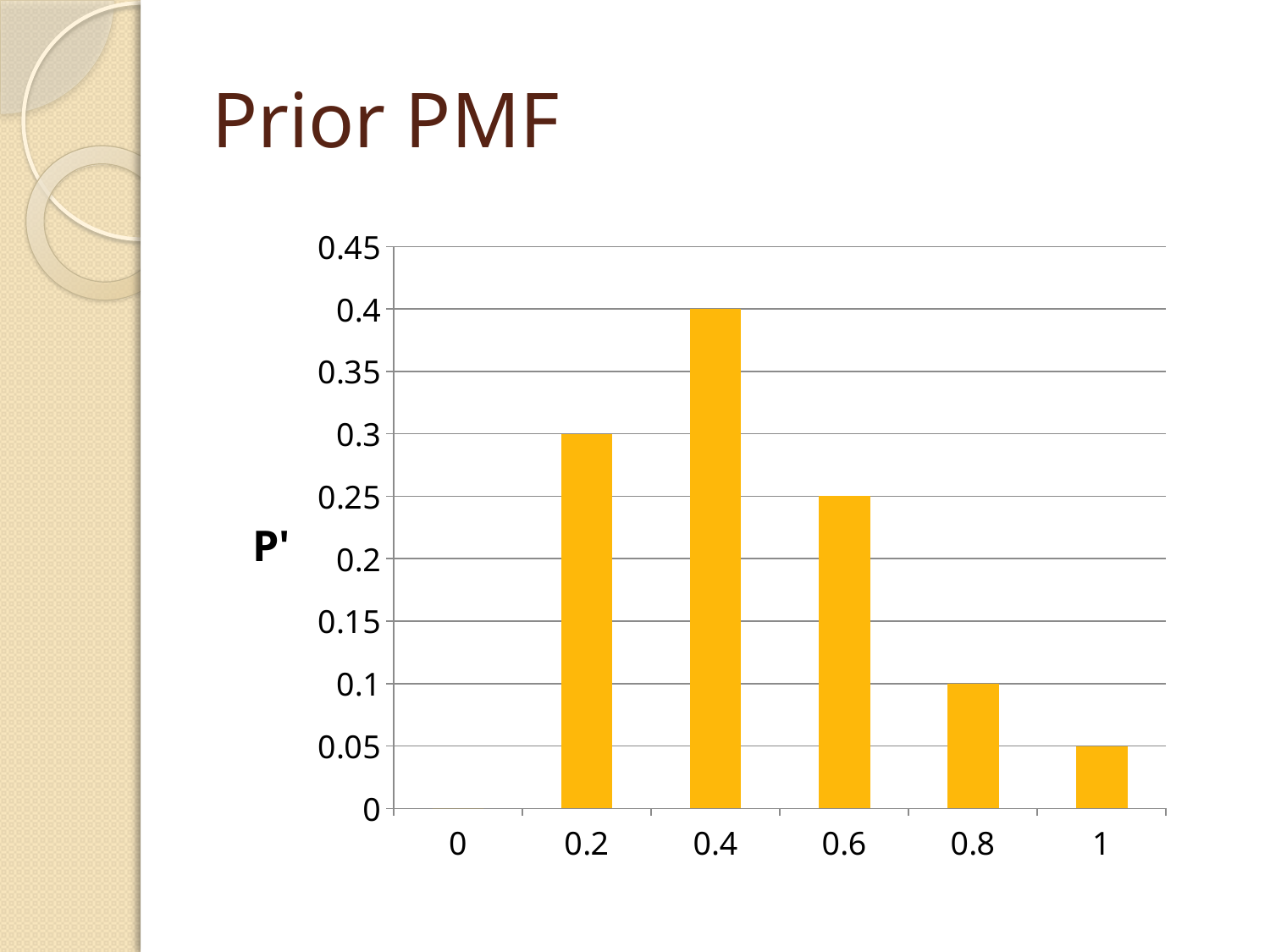
What is the label on the vertical axis? P' What is the difference between the values at 0.4 and 0.8? 0.3 What is the value of P' at 0.6? 0.25 Which x-axis category has the highest bar? 0.4 Is the value at 0.8 greater or less than 0.2? less What is the value of P' at 0.4? 0.4 What is the value of P' at 1? 0.05 What is the value of P' at 0.2? 0.3 Which x-axis category has the lowest visible bar? 1 How many categories are shown on the x axis? 6 Which is larger, the value at 0.2 or the value at 0.6? 0.2 What type of chart is shown on the slide? bar chart